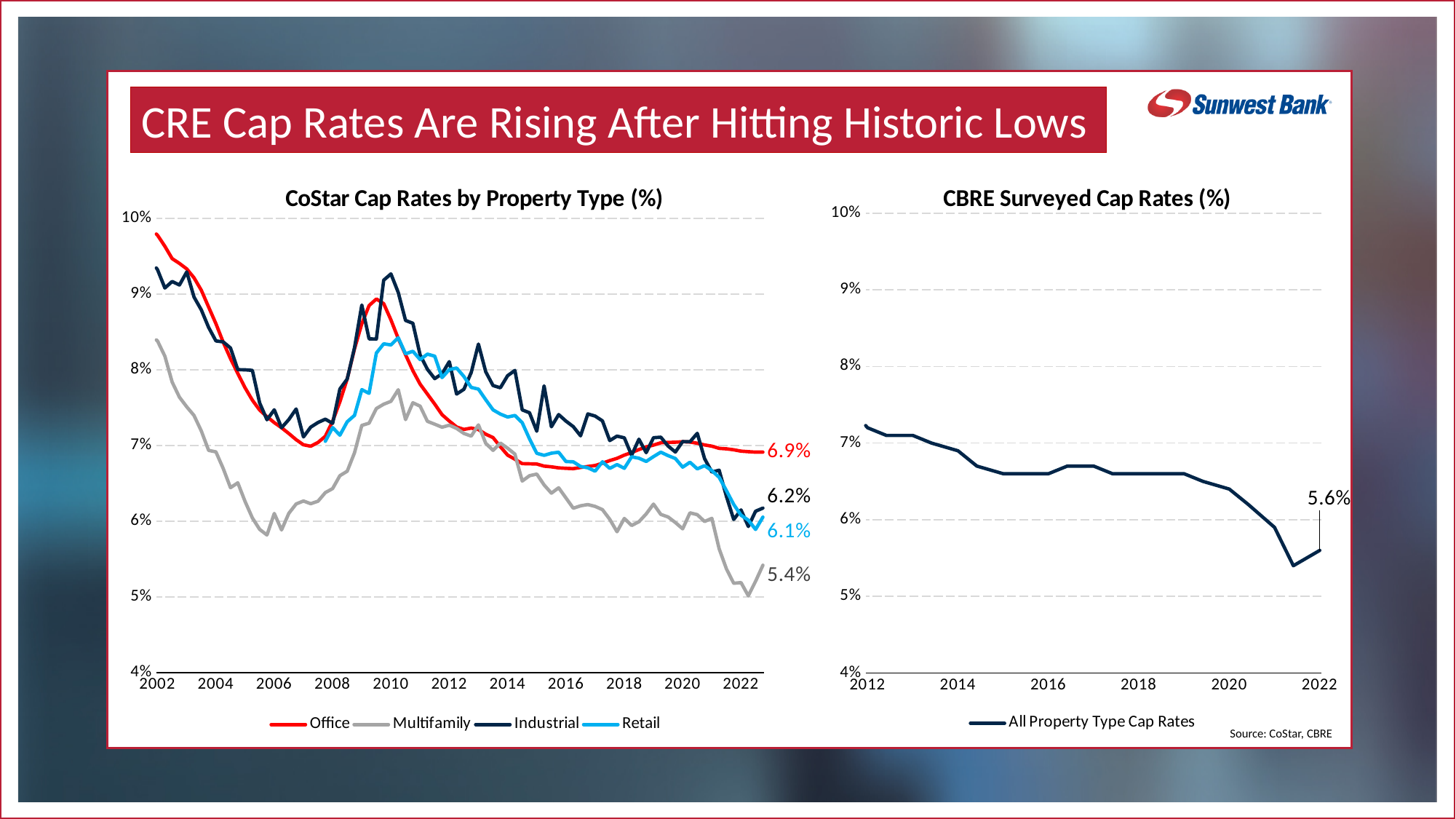
In the CoStar Cap Rates by Property Type chart, is the Office value in 2002 greater or less than 9%? greater In the CoStar Cap Rates by Property Type chart, which series has the lowest labelled value at the end of the period? Multifamily In the CoStar Cap Rates by Property Type chart, which series has the highest labelled value at the end of the period? Office In the CoStar Cap Rates by Property Type chart, what is the latest labelled value for the Multifamily series? 5.4% In the CBRE Surveyed Cap Rates chart, do the values generally rise or fall from 2012 to 2021? Fall In the CoStar Cap Rates by Property Type chart, what is the latest labelled value for the Office series? 6.9% In the CBRE Surveyed Cap Rates chart, what is the labelled value at the end of the line in 2022? 5.6% What kind of chart is the CBRE Surveyed Cap Rates chart? Line chart How many series does the legend of the CoStar Cap Rates by Property Type chart list? 4 In the CoStar Cap Rates by Property Type chart, is the final labelled Industrial value larger or smaller than the final labelled Retail value? Larger In the CoStar Cap Rates by Property Type chart, what is the latest labelled value for the Retail series? 6.1% In the CoStar Cap Rates by Property Type chart, what is the difference between the final labelled Office value and the final labelled Multifamily value? 1.5%